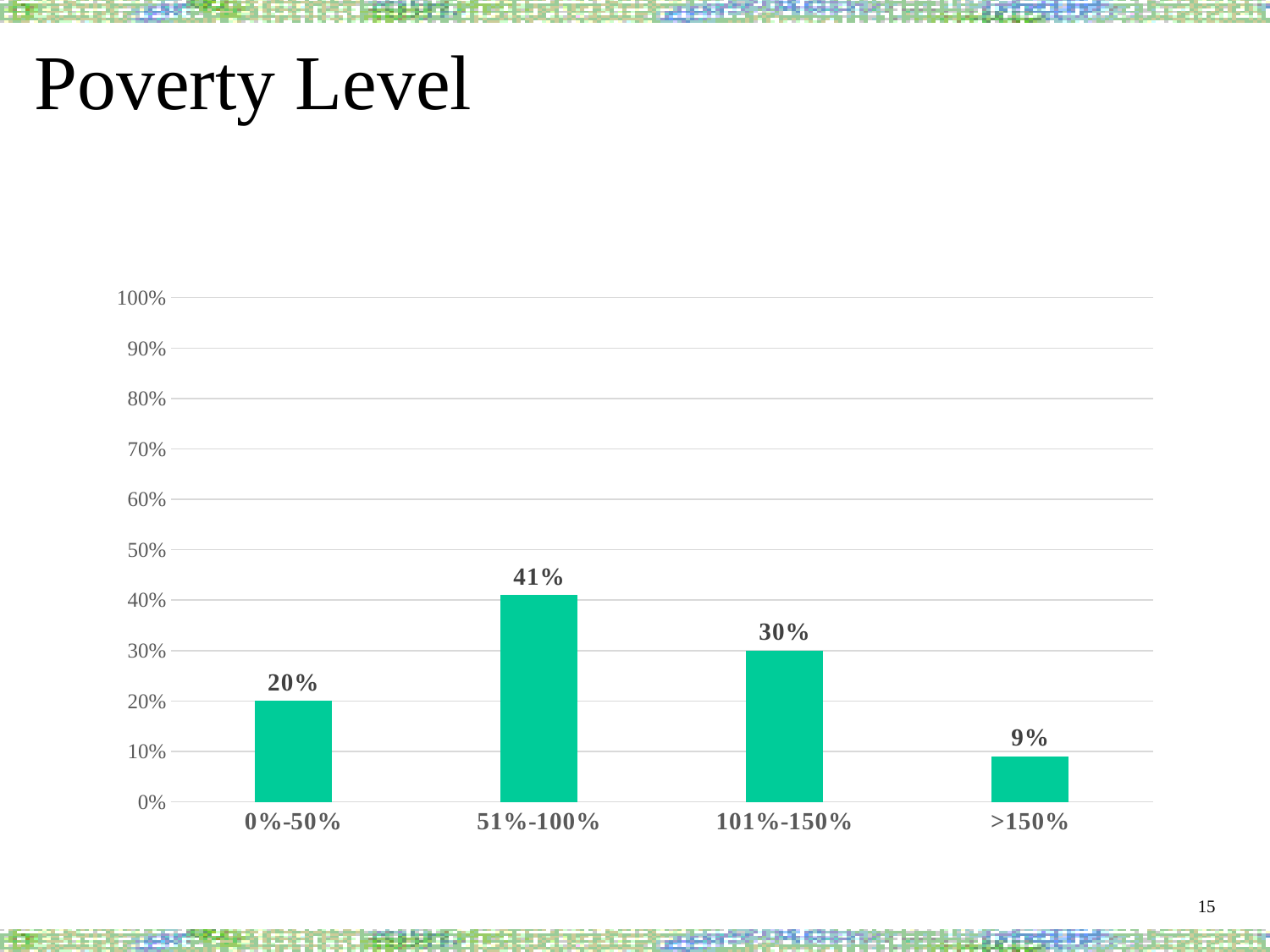
What is the value for the >150% category? 9% Which poverty level category has the lowest value? >150% What is the value for the 51%-100% category? 41% What is the value for the 101%-150% category? 30% Which is larger, the value for 0%-50% or the value for 101%-150%? 101%-150% Which poverty level category has the highest value? 51%-100% What is the value for the 0%-50% poverty level category? 20% Is the value for 51%-100% greater or less than 50%? less What is the difference between the values for 0%-50% and >150%? 11% What kind of chart is shown on the slide? Bar chart What is the difference between the values for 51%-100% and 101%-150%? 11% How many categories are shown on the chart? 4